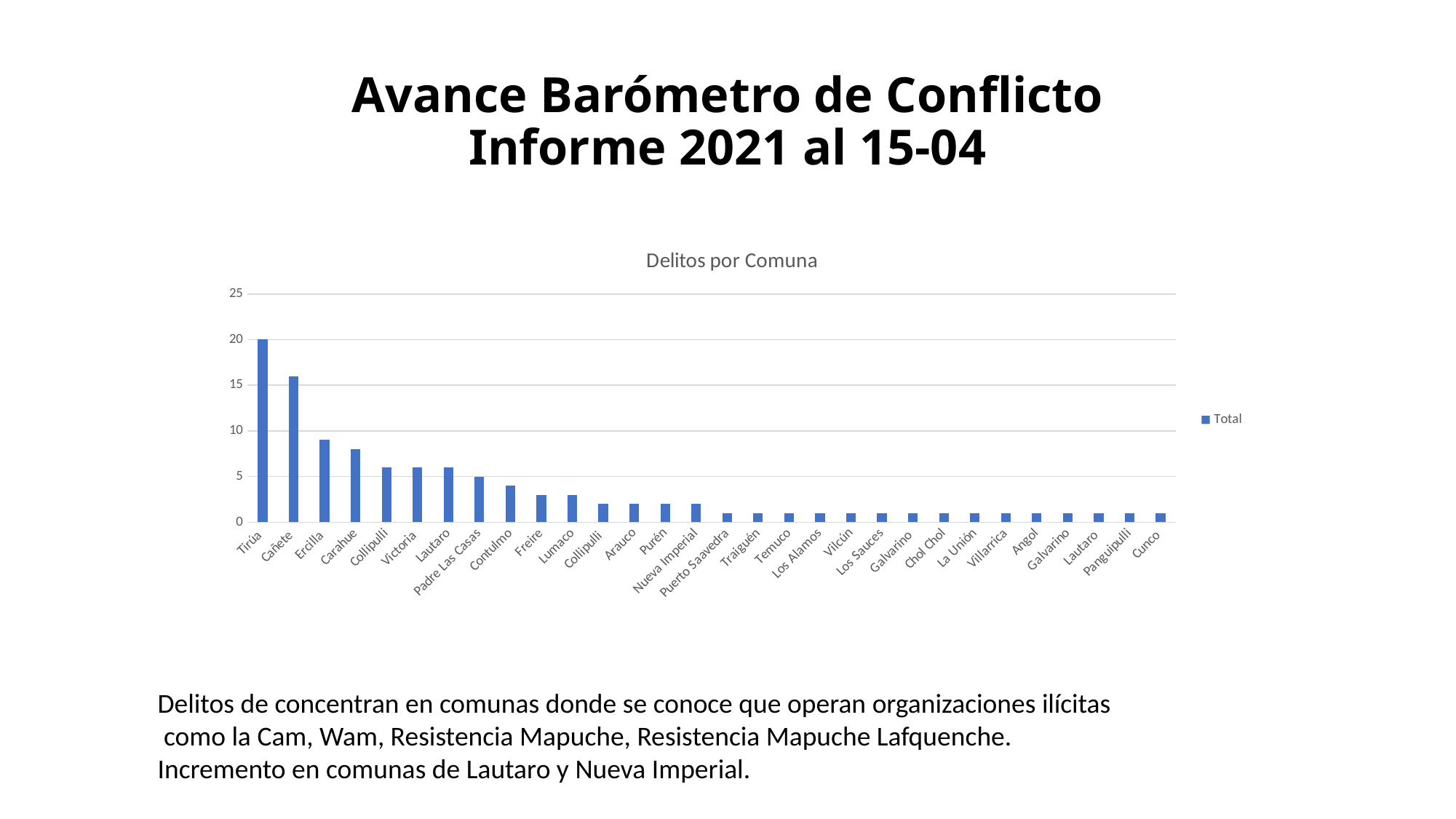
Is the value for Cañete greater or less than 15? greater What is the value for Tirúa in the Delitos por Comuna chart? 20 What is the value for Padre Las Casas in the Delitos por Comuna chart? 5 Which has a larger value, Cañete or Ercilla? Cañete Which has a larger value, Carahue or Freire? Carahue Do the values rise or fall from left to right along the x axis? fall What kind of chart is shown on the slide? bar chart What is the title of the chart? Delitos por Comuna How many series does the legend list? 1 Which comuna has the highest value in the Delitos por Comuna chart? Tirúa Is the value for Contulmo greater or less than 5? less Is the value for Ercilla greater or less than 10? less